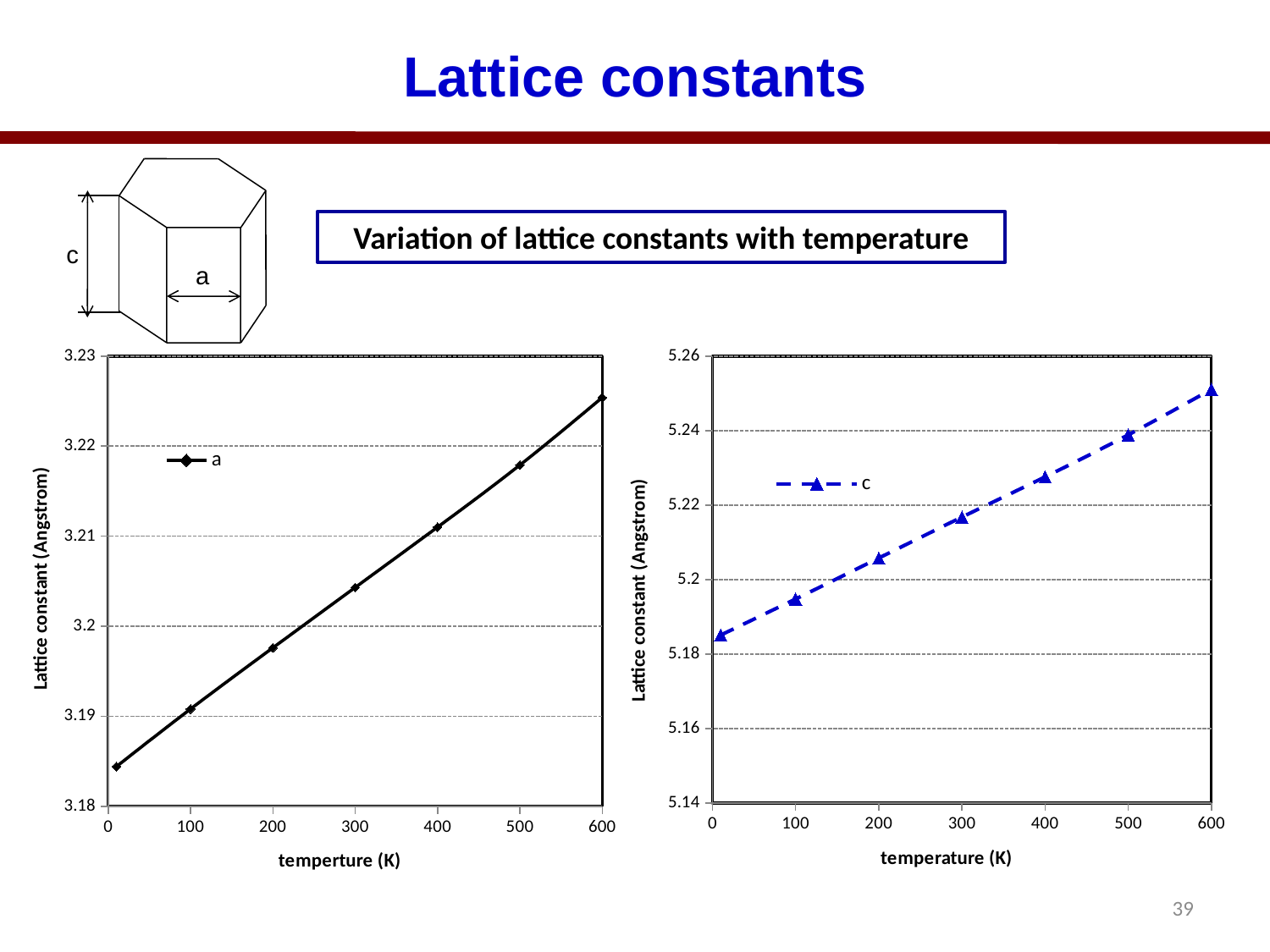
How many series does the legend of the left chart list? 1 How many data points are plotted in the right chart (series c)? 7 In the right chart, is the value of c at 100 K greater or less than 5.2? less In the left chart, does the lattice constant a rise or fall as temperature increases? rise In the right chart, does the lattice constant c rise or fall as temperature increases? rise In the right chart, is the value of c at 600 K greater or less than 5.24? greater What kind of chart is the right chart (series c)? line chart How many series does the legend of the right chart list? 1 In the left chart, is the value of a at 100 K greater or less than 3.2? less What is the y-axis title of the right chart? Lattice constant (Angstrom) What kind of chart is the left chart (series a)? line chart